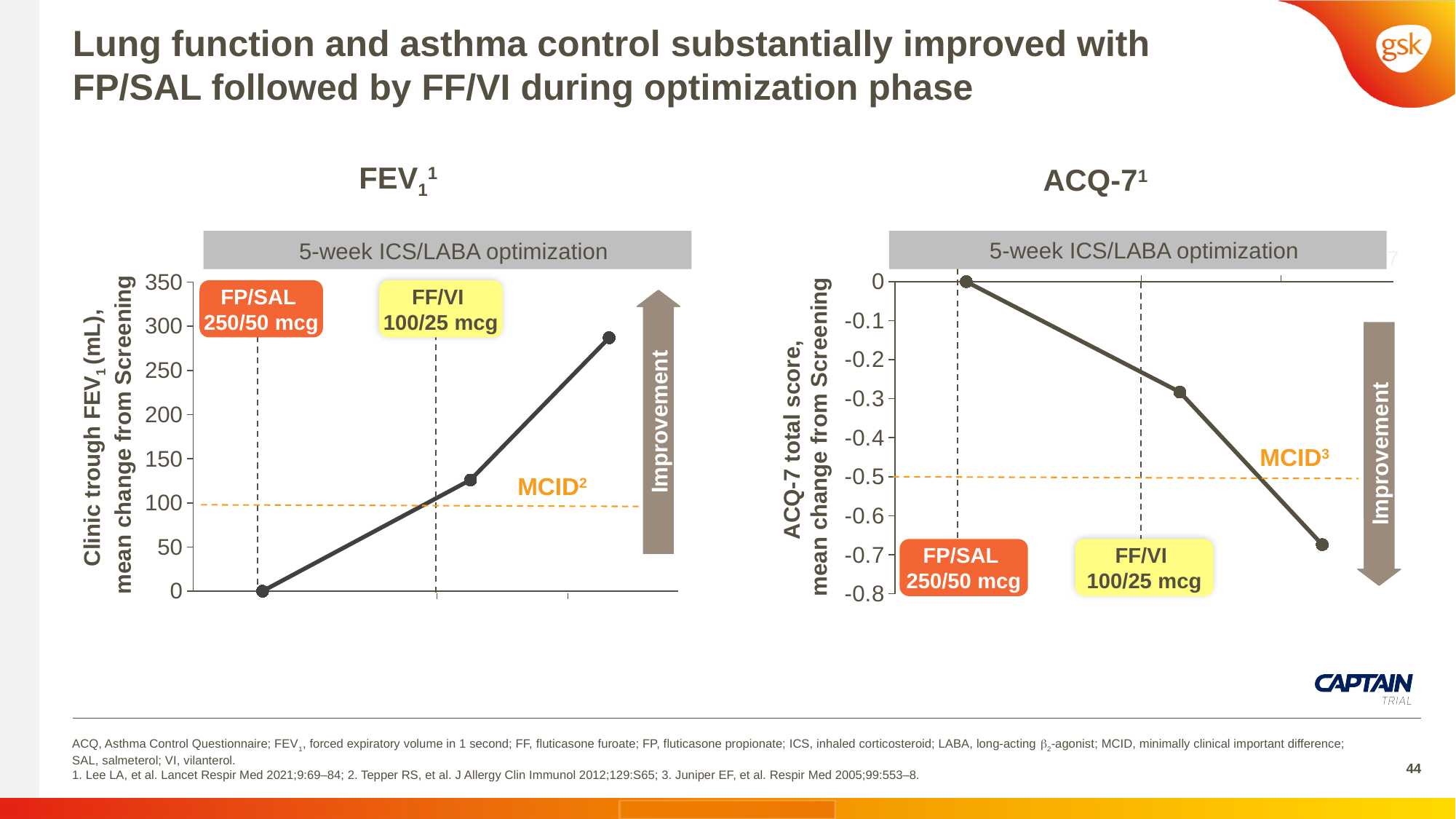
On the ACQ-7 chart, do the values rise or fall from left to right? Fall On the ACQ-7 chart, at what value is the dashed MCID line drawn? -0.5 What does the grey banner above each chart say? 5-week ICS/LABA optimization On the ACQ-7 chart, what is the value of the first plotted point? 0 On the ACQ-7 chart, is the value of the last plotted point greater or less than -0.6? less On the FEV1 chart, what is the value of the first plotted point? 0 On the FEV1 chart, do the values rise or fall from left to right? Rise On the FEV1 chart, is the value of the middle plotted point greater or less than 100? greater How many data points are plotted on the FEV1 chart? 3 How many data points are plotted on the ACQ-7 chart? 3 On the FEV1 chart, is the value of the last plotted point greater or less than 250? greater What kind of chart is the FEV1 chart on the left? Line chart